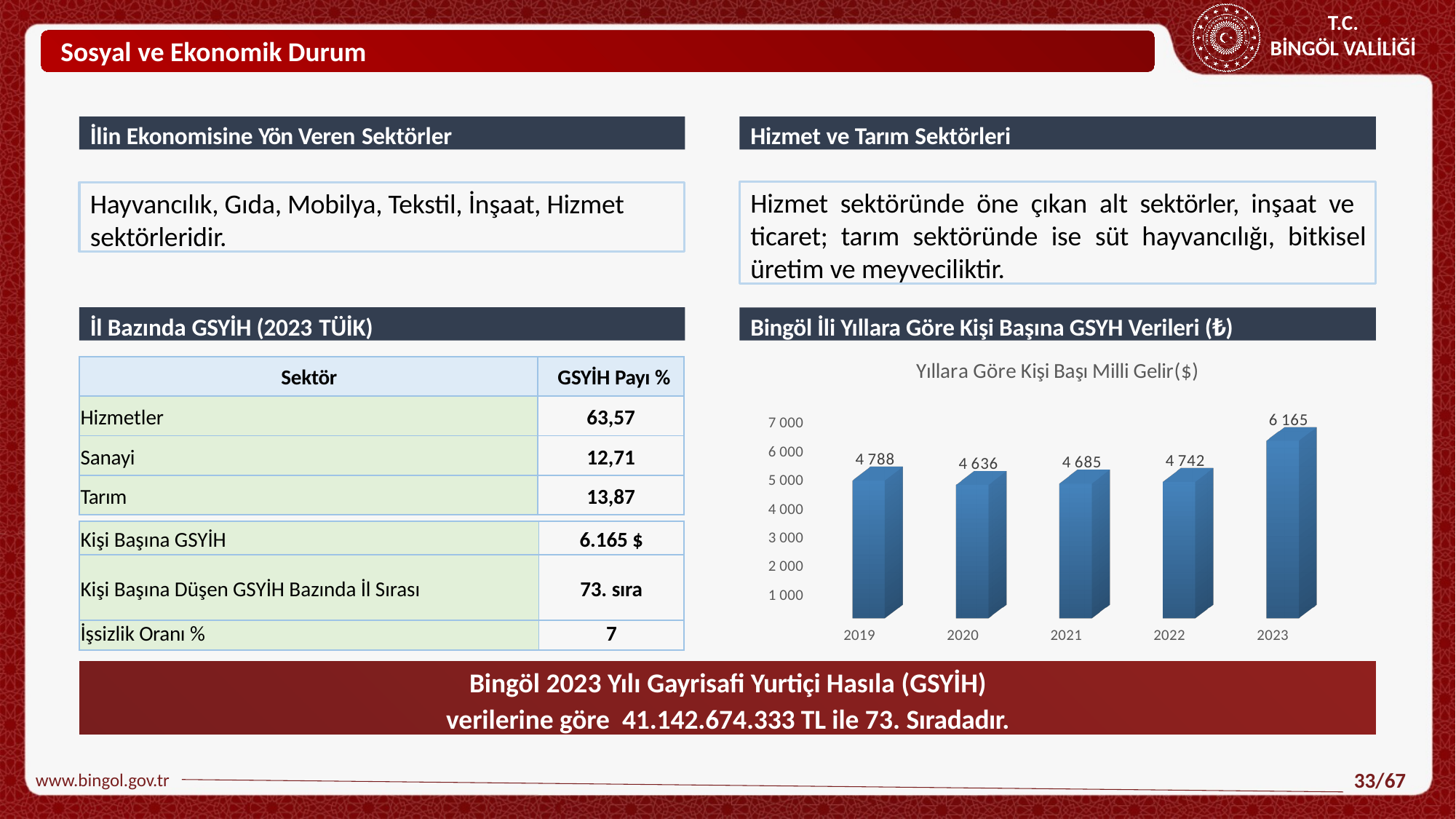
What kind of chart is shown on the slide? bar chart What is the difference between the values for 2019 and 2020? 152 What is the value for 2019 in the chart? 4 788 Which year has the highest value in the chart? 2023 Which year has the lowest value in the chart? 2020 What is the title of the chart? Yıllara Göre Kişi Başı Milli Gelir($) What is the value for 2023 in the chart? 6 165 What is the value for 2021 in the chart? 4 685 How many years are shown in the chart? 5 Is the value for 2023 greater or less than 6 000? greater What is the difference between the values for 2023 and 2022? 1 423 Which is larger, the value for 2019 or the value for 2022? 2019